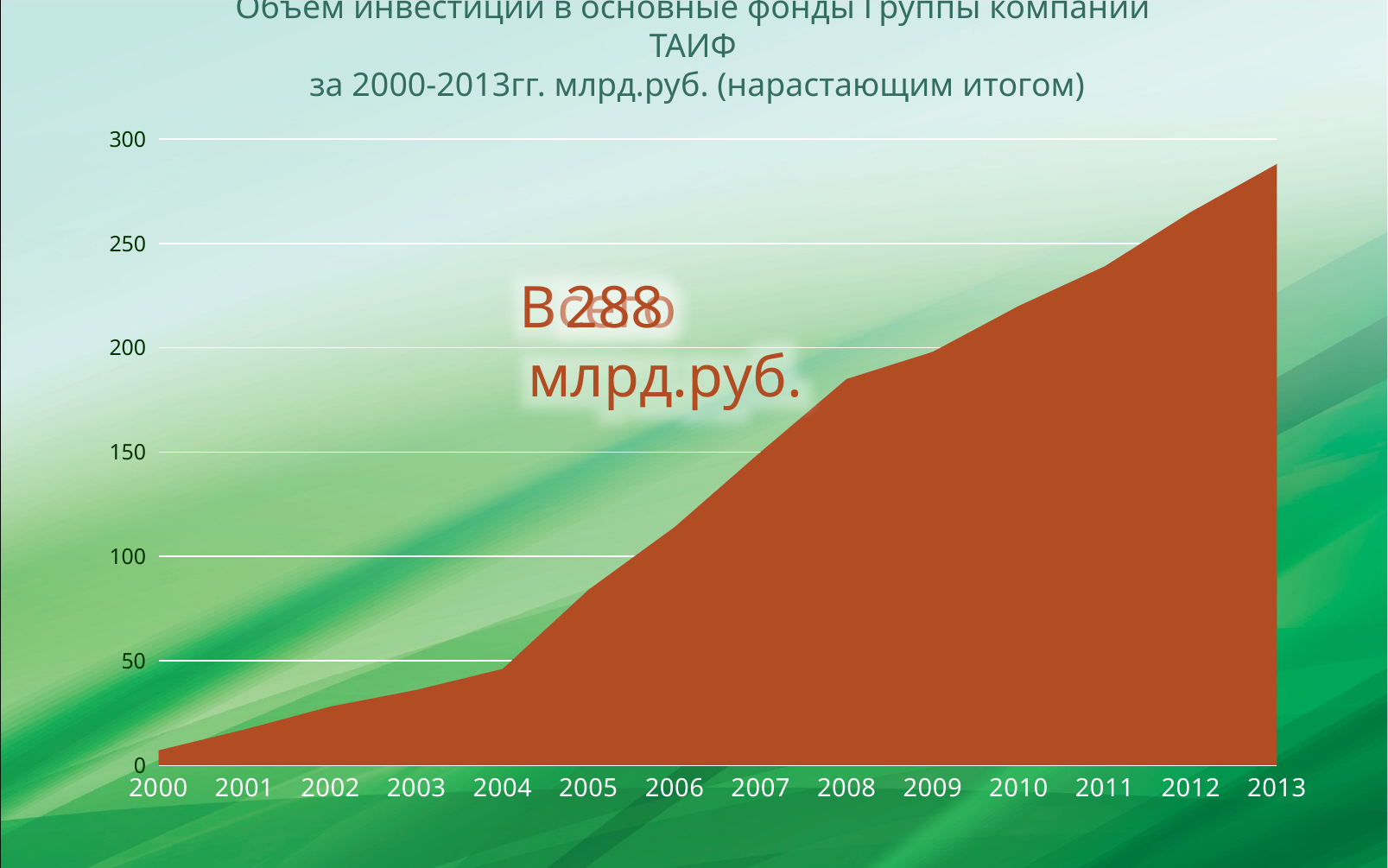
What kind of chart is shown on the slide? area chart Which year has the larger value, 2005 or 2010? 2010 Do the values rise or fall from 2000 to 2013? rise Is the value for 2004 greater or less than 50? less Is the value for 2006 greater or less than 100? greater Which year has the lowest cumulative investment value? 2000 Which year has the highest cumulative investment value? 2013 What total cumulative investment amount is stated in the text annotation on the chart? 288 млрд.руб. Is the value for 2008 greater or less than 150? greater How many years are shown on the x axis of the chart? 14